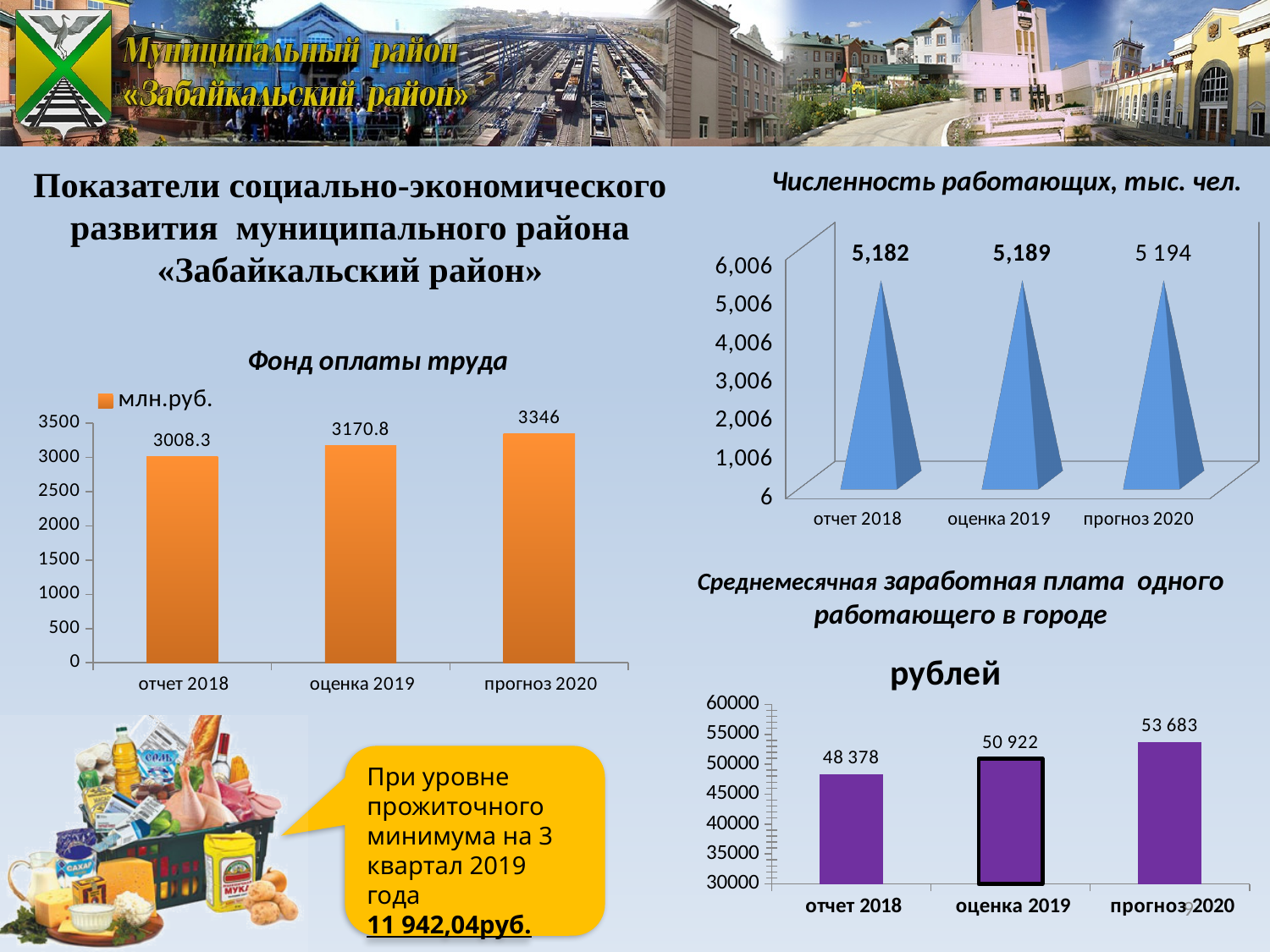
In the 'Среднемесячная заработная плата одного работающего в городе' chart, what is the value for 'отчет 2018'? 48 378 In the 'Численность работающих, тыс. чел.' chart, what is the value for 'прогноз 2020'? 5 194 In the 'Фонд оплаты труда' chart, what is the difference between 'оценка 2019' and 'отчет 2018'? 162.5 How many categories are shown in the 'Численность работающих, тыс. чел.' chart? 3 In the 'Фонд оплаты труда' chart, what is the value for 'прогноз 2020'? 3346 In the 'Фонд оплаты труда' chart, what is the value for 'отчет 2018'? 3008.3 What kind of chart is the 'Среднемесячная заработная плата одного работающего в городе' chart? bar chart In the 'Фонд оплаты труда' chart, do the values rise or fall from 'отчет 2018' to 'прогноз 2020'? rise In the 'Среднемесячная заработная плата одного работающего в городе' chart, which category has the highest value? прогноз 2020 In the 'Среднемесячная заработная плата одного работающего в городе' chart, what is the difference between 'прогноз 2020' and 'оценка 2019'? 2 761 In the 'Численность работающих, тыс. чел.' chart, what is the value for 'оценка 2019'? 5,189 In the 'Фонд оплаты труда' chart, what unit does the legend show? млн.руб.